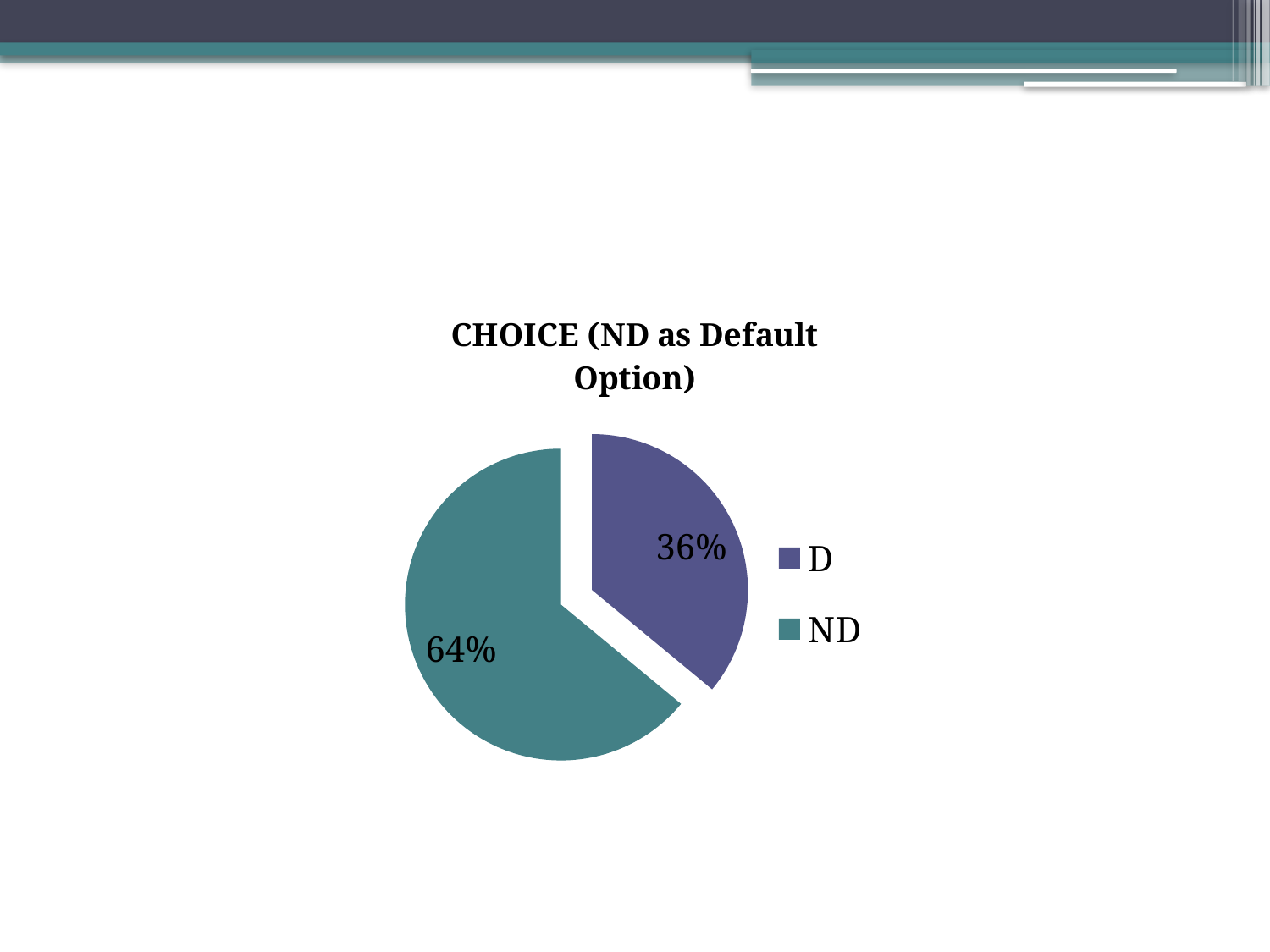
Which is larger, the share for D or the share for ND? ND How many entries does the legend list? 2 How many slices does the pie chart have? 2 What is the difference in percentage points between the ND share and the D share? 28 What share of the pie does D represent? 36% What share of the pie does ND represent? 64% Which category has the largest slice of the pie? ND Which category has the smallest slice of the pie? D What is the title of the chart? CHOICE (ND as Default Option) Which legend entry is shown in purple? D What kind of chart is shown on the slide? pie chart